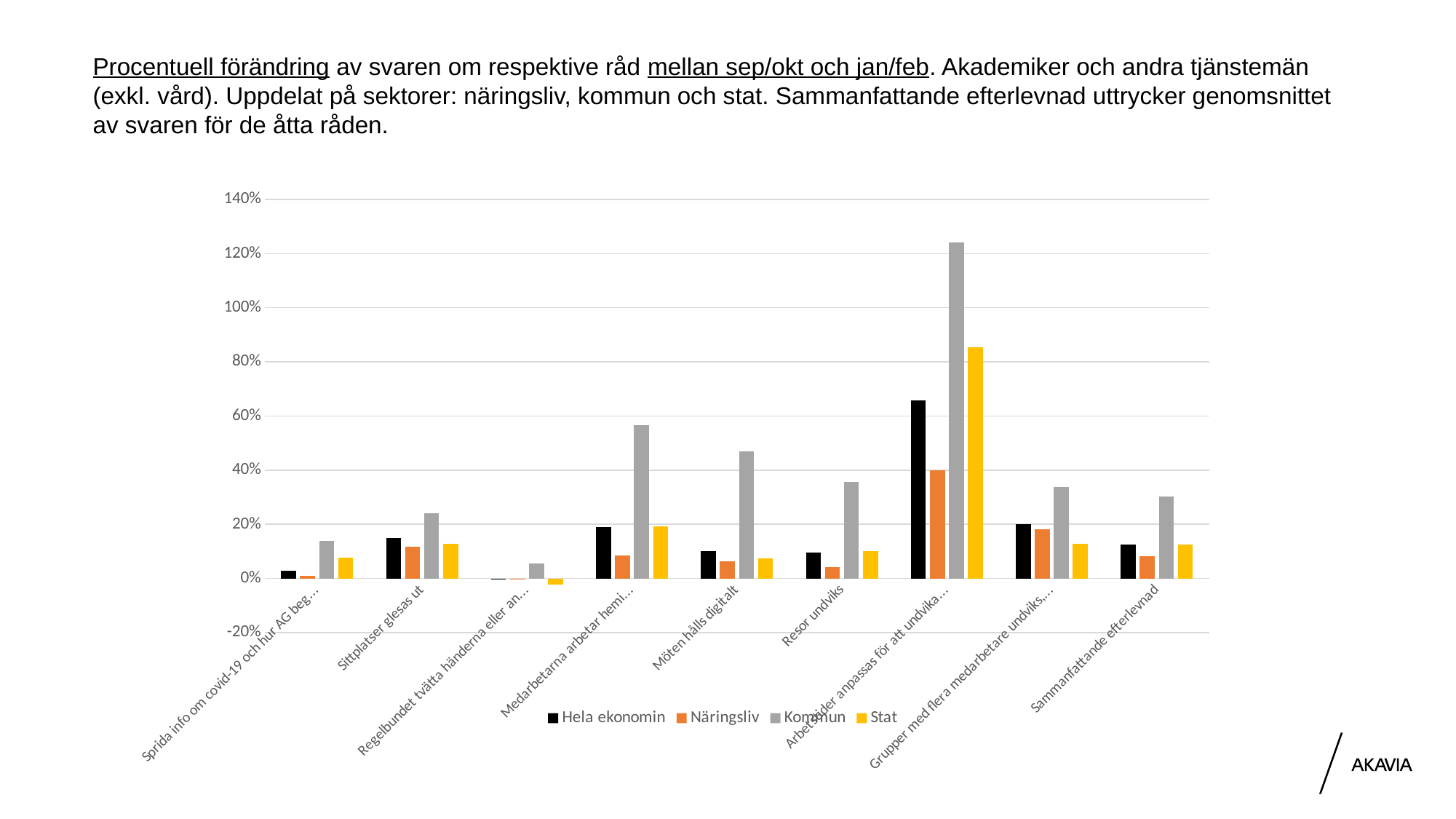
What colour are the bars for the Stat series? yellow How many categories are plotted along the x axis? 9 For "Resor undviks", which is larger: the Kommun value or the Stat value? Kommun How many series does the legend list? 4 What kind of chart is shown on the slide? bar chart Is the Kommun value for "Sammanfattande efterlevnad" greater or less than 20%? greater Which series has the lowest value for "Sammanfattande efterlevnad"? Näringsliv Which series has the highest value for "Möten hålls digitalt"? Kommun Is the Stat value for "Sittplatser glesas ut" greater or less than 20%? less For "Sittplatser glesas ut", which is larger: the Hela ekonomin value or the Näringsliv value? Hela ekonomin Is the Kommun value for "Möten hålls digitalt" greater or less than 40%? greater